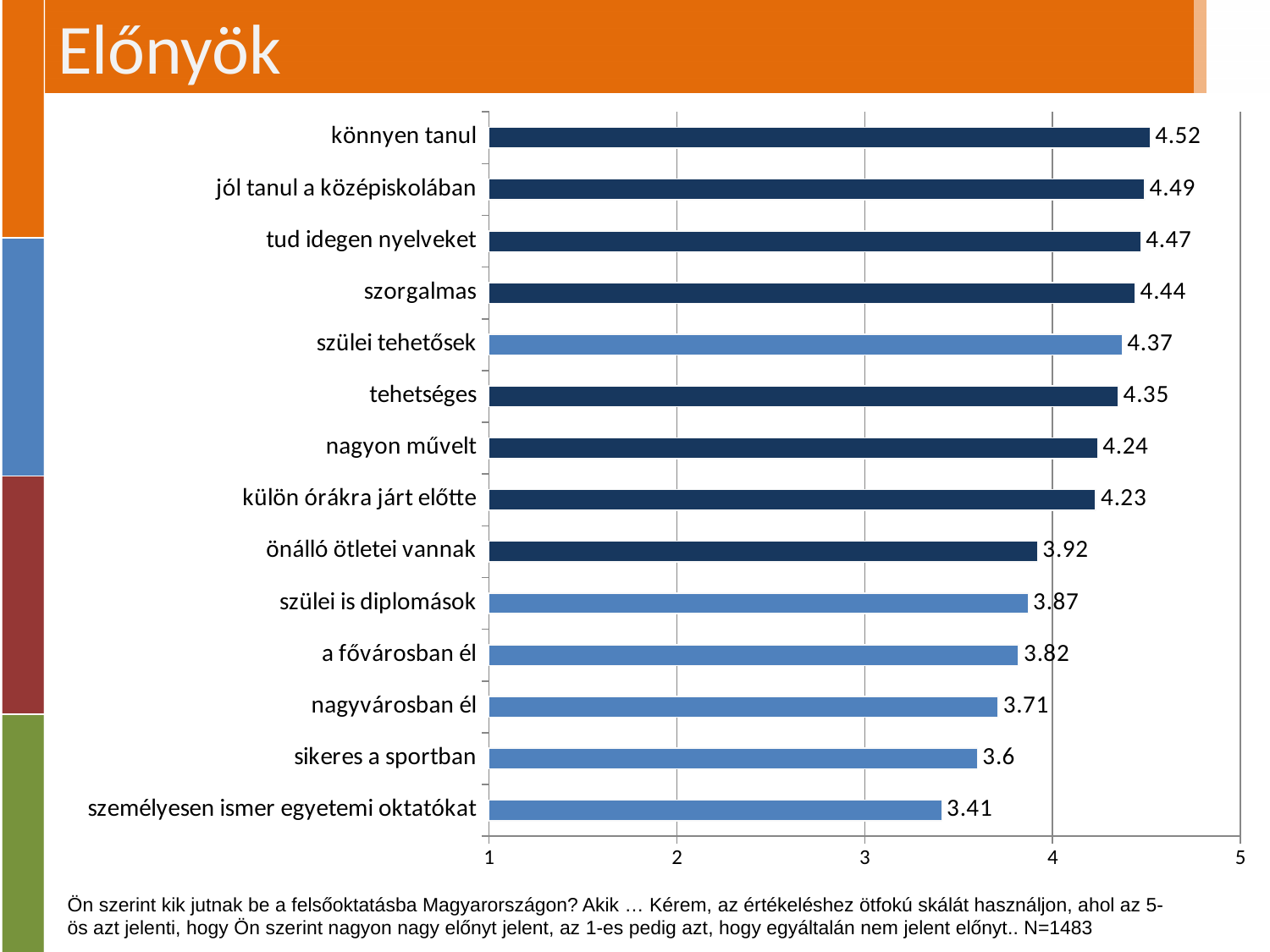
Is the value for "a fővárosban él" greater or less than 4? less Which has a larger value, "szorgalmas" or "nagyvárosban él"? szorgalmas What is the value for "szülei is diplomások"? 3.87 What is the difference between the values for "nagyon művelt" and "sikeres a sportban"? 0.64 What kind of chart is shown on the slide? bar chart Which category has the lowest value? személyesen ismer egyetemi oktatókat What is the difference between the values for "könnyen tanul" and "személyesen ismer egyetemi oktatókat"? 1.11 What is the value for "könnyen tanul"? 4.52 What is the title of the slide? Előnyök Which category has the highest value? könnyen tanul What is the value for "sikeres a sportban"? 3.6 How many categories are shown in the chart? 14